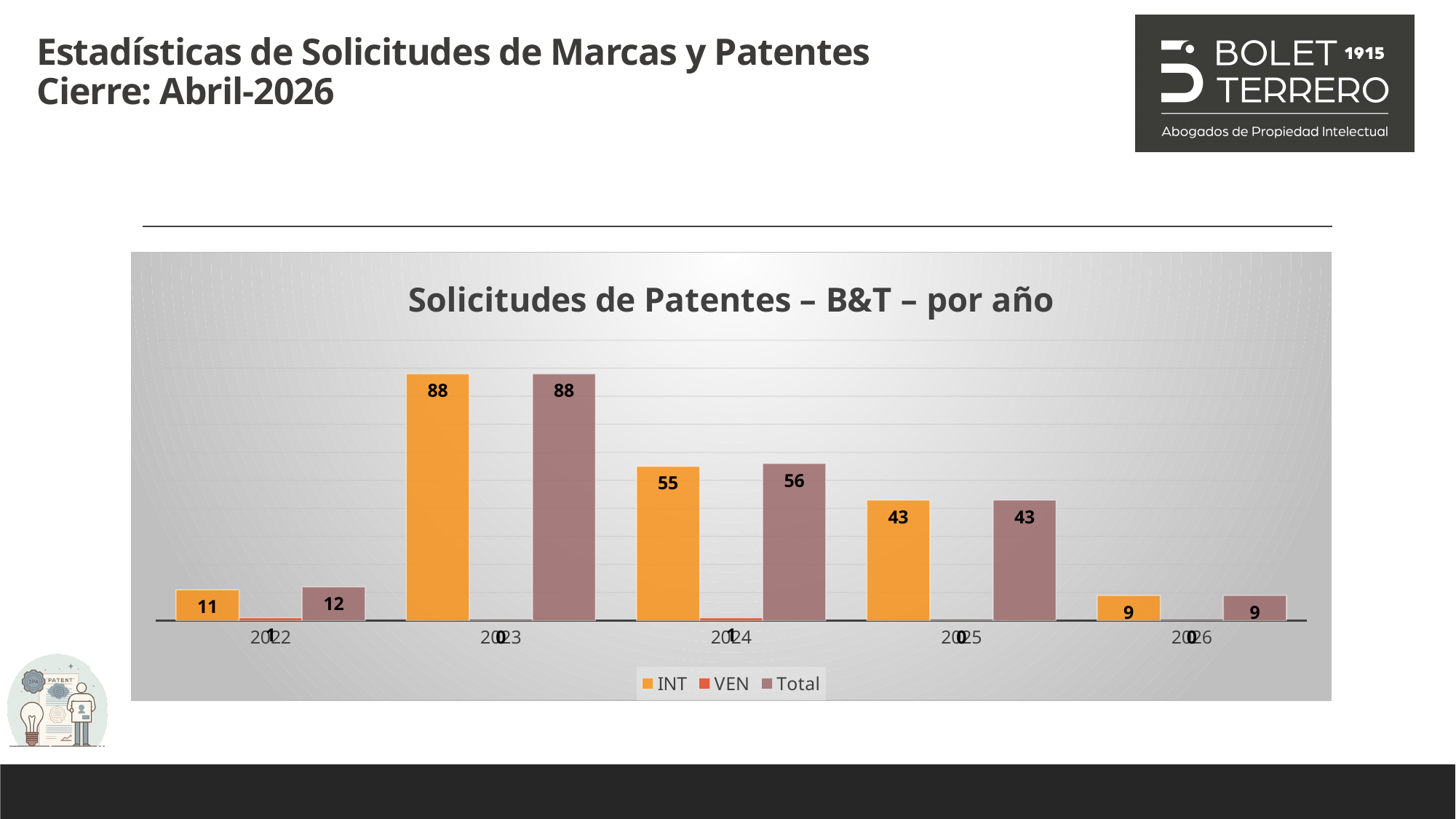
How many years are shown on the x axis? 5 Which year has the highest INT value? 2023 How many series does the legend list? 3 What is the Total value for 2024? 56 What is the difference between the INT values for 2023 and 2024? 33 What is the INT value for 2026? 9 Do the INT values rise or fall from 2023 to 2026? fall What kind of chart is shown on the slide? bar chart What is the INT value for 2023? 88 Which year has the lowest Total value? 2026 Which is larger for 2022, the INT value or the Total value? Total What is the Total value for 2022? 12